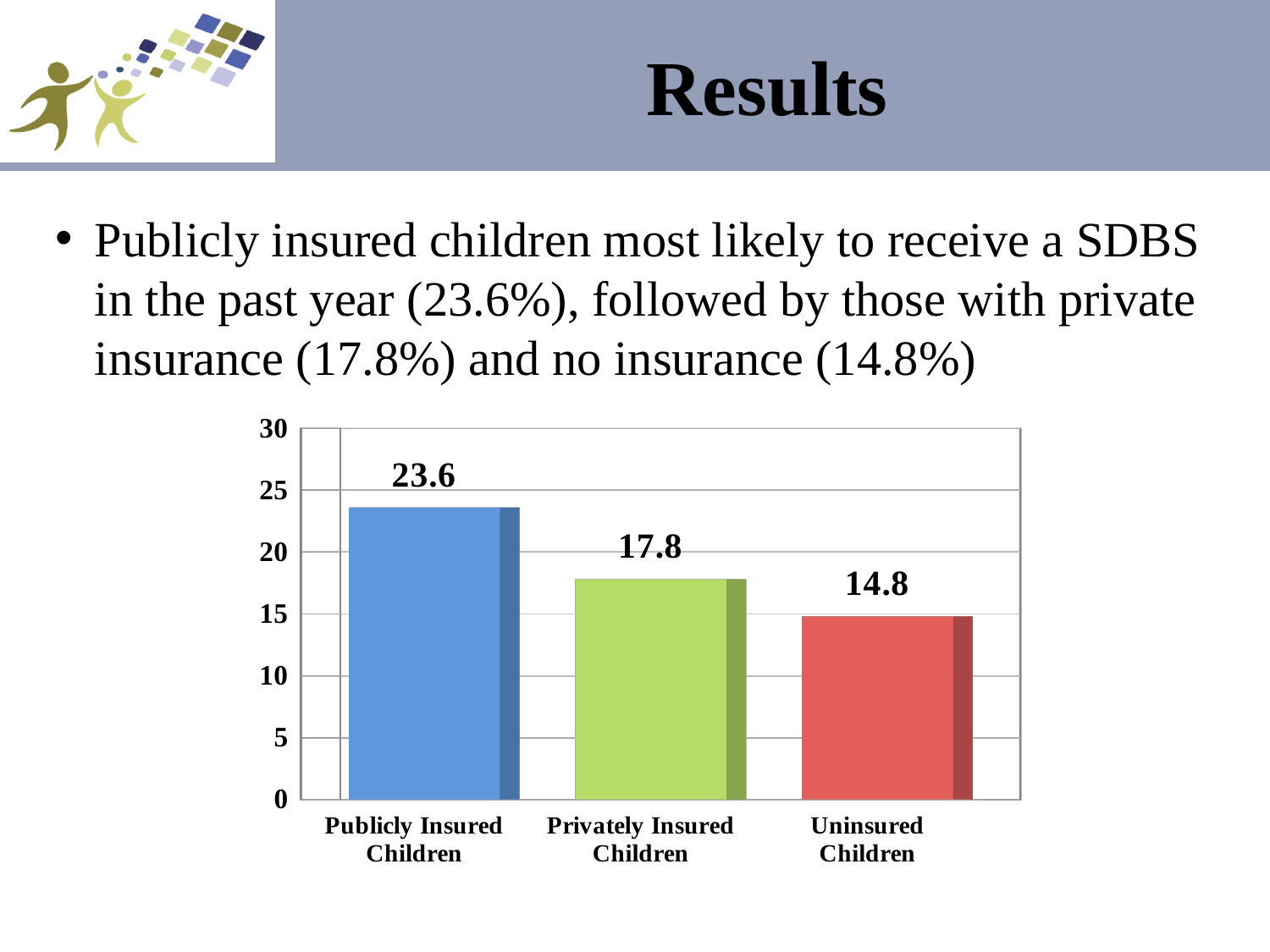
Do the values rise or fall from left to right across the categories? fall What is the value for Uninsured Children? 14.8 What is the value for Privately Insured Children? 17.8 What is the value for Publicly Insured Children? 23.6 What kind of chart is shown on the slide? bar chart What is the difference between the values for Privately Insured Children and Uninsured Children? 3.0 What is the difference between the values for Publicly Insured Children and Uninsured Children? 8.8 Which is larger, the value for Privately Insured Children or Uninsured Children? Privately Insured Children Which category has the highest value? Publicly Insured Children Is the value for Publicly Insured Children greater or less than 20? greater How many categories are shown in the chart? 3 Which category has the lowest value? Uninsured Children